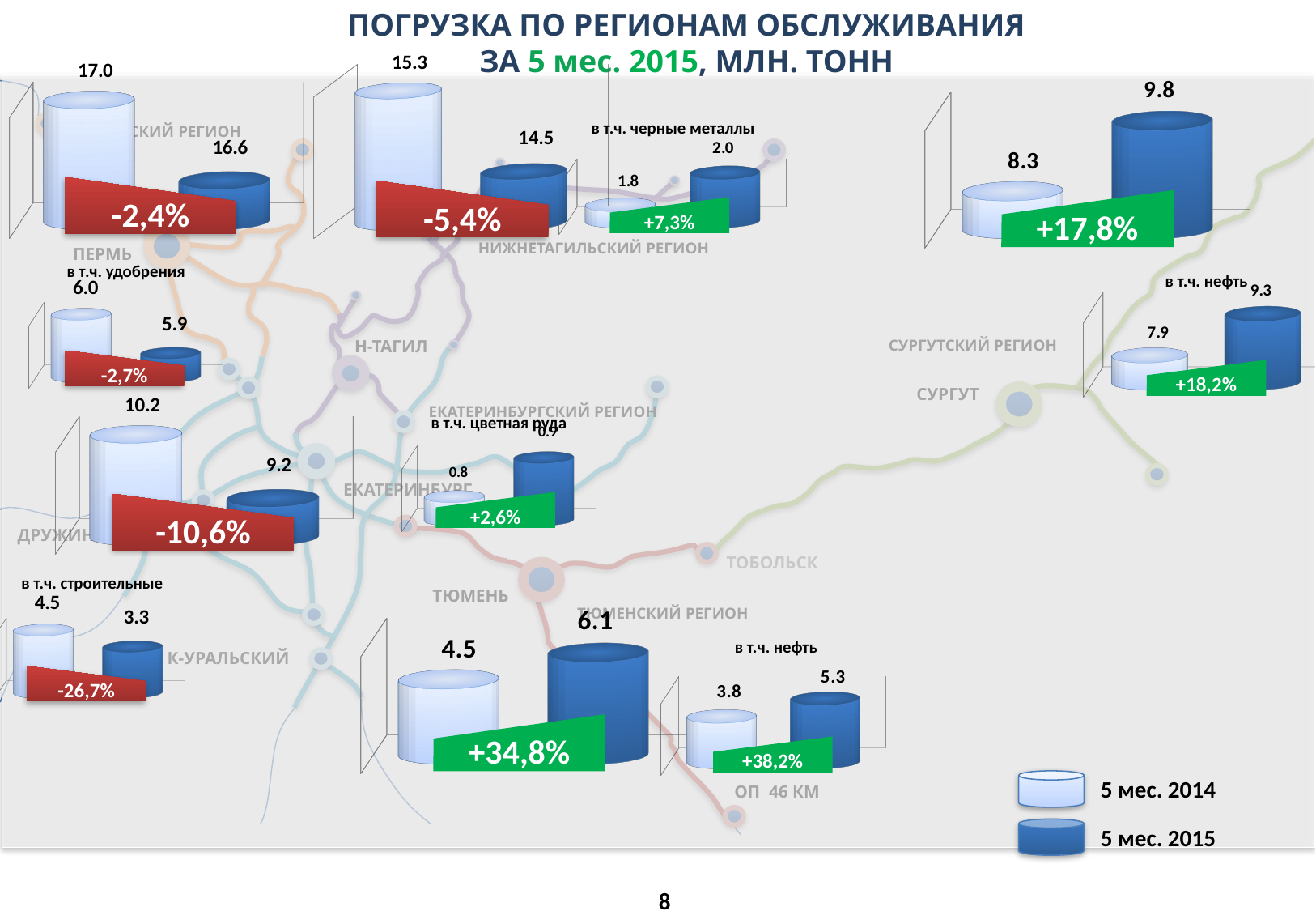
In the top-left chart (above ПЕРМЬ), what percentage change is shown? -2,4% In the chart for ТЮМЕНСКИЙ РЕГИОН (bottom centre), what is the value for 5 мес. 2015? 6.1 In the top-left chart (above ПЕРМЬ), what is the value for 5 мес. 2015? 16.6 In the chart 'в т.ч. нефть' for ТЮМЕНСКИЙ РЕГИОН, what percentage change is shown? +38,2% In the chart for НИЖНЕТАГИЛЬСКИЙ РЕГИОН, what is the difference between the 5 мес. 2014 and 5 мес. 2015 values? 0.8 In the chart for НИЖНЕТАГИЛЬСКИЙ РЕГИОН, what is the value for 5 мес. 2014? 15.3 In the chart for СУРГУТСКИЙ РЕГИОН (top right), what percentage change is shown? +17,8% In the chart 'в т.ч. нефть' next to СУРГУТСКИЙ РЕГИОН, what is the value for 5 мес. 2015? 9.3 In the chart for СУРГУТСКИЙ РЕГИОН (top right), which is larger, the 5 мес. 2014 value or the 5 мес. 2015 value? 5 мес. 2015 How many series does the legend at the bottom right list? 2 In the chart 'в т.ч. строительные' (bottom left), what is the difference between the 5 мес. 2014 and 5 мес. 2015 values? 1.2 In the chart for ЕКАТЕРИНБУРГСКИЙ РЕГИОН (10.2 and 9.2), what percentage change is shown? -10,6%